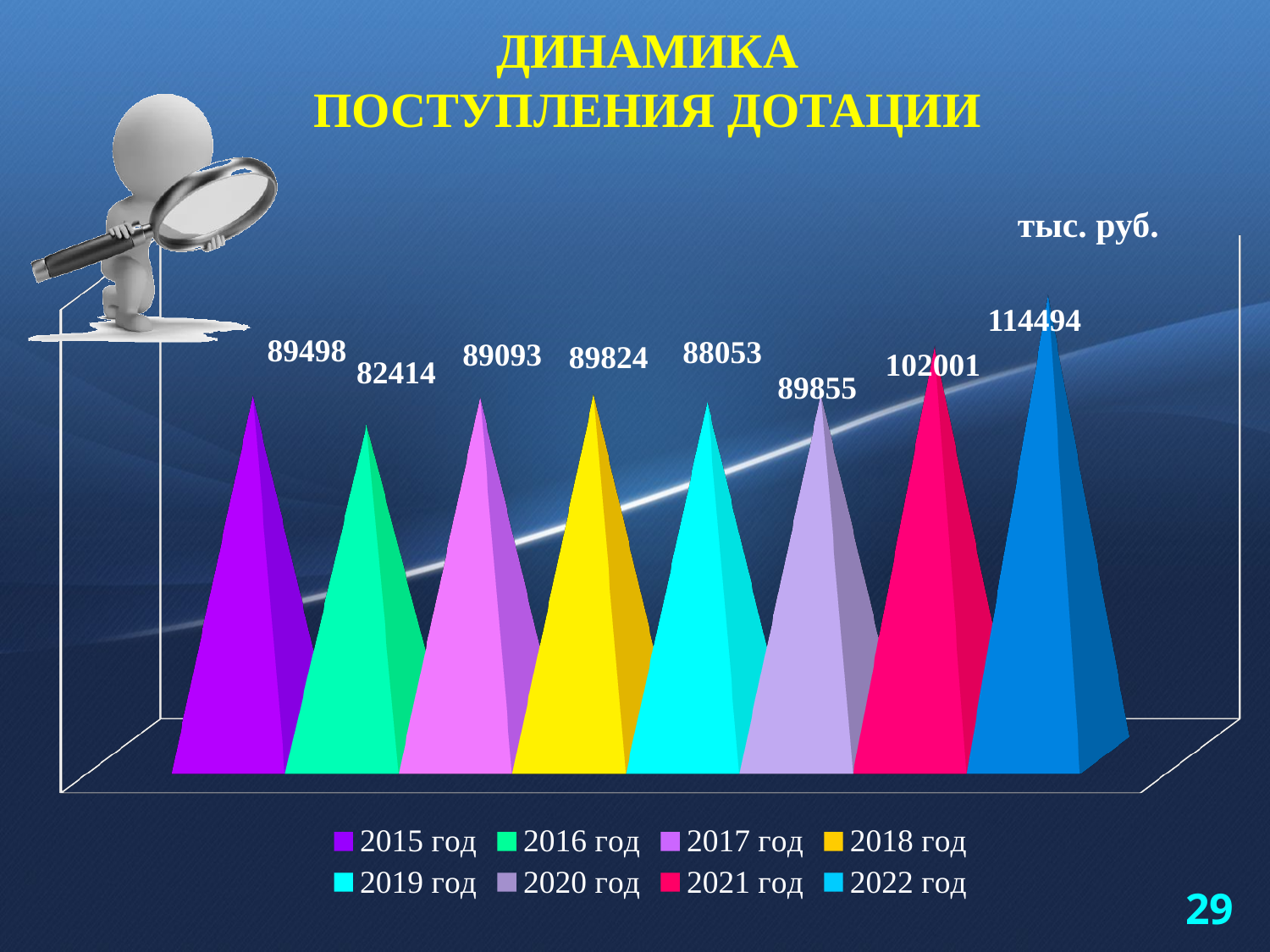
Which year has the lowest value? 2016 год What is the difference between the values for 2022 год and 2021 год? 12493 How many entries does the legend list? 8 How many years are shown in the chart? 8 What is the difference between the values for 2015 год and 2016 год? 7084 What is the value for 2021 год? 102001 Which is larger, the value for 2018 год or the value for 2019 год? 2018 год What is the value for 2015 год? 89498 What unit is indicated for the values in the chart? тыс. руб. Which year has the highest value? 2022 год What is the value for 2022 год? 114494 What is the value for 2019 год? 88053